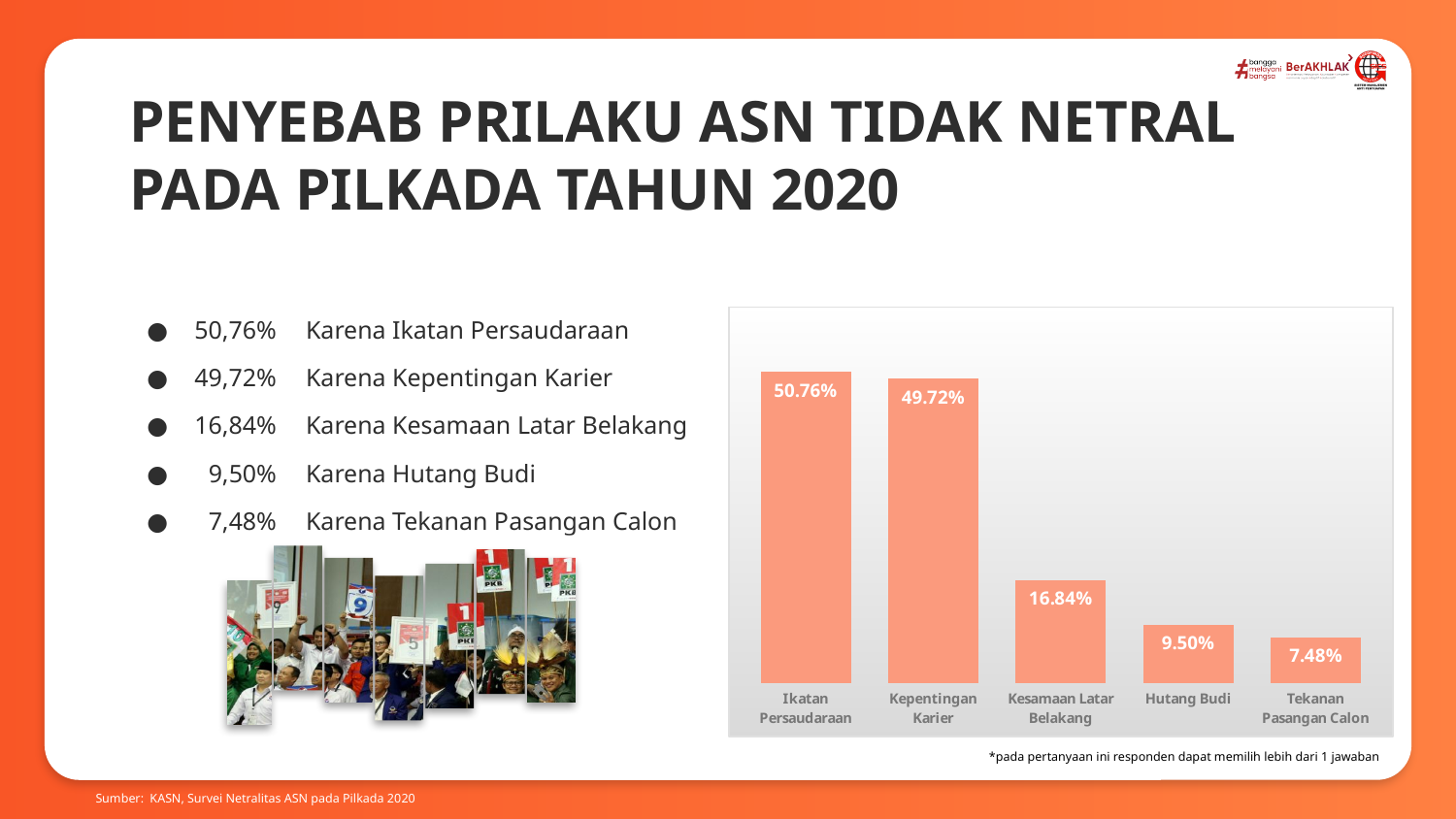
How many categories does the bar chart show? 5 What is the value for Ikatan Persaudaraan? 50.76% Which category has the lowest value? Tekanan Pasangan Calon What is the value for Hutang Budi? 9.50% Do the values rise or fall from left to right across the categories? fall What is the value for Kepentingan Karier? 49.72% What kind of chart is shown on the slide? bar chart What is the value for Tekanan Pasangan Calon? 7.48% Which category has the highest value? Ikatan Persaudaraan Which is larger, the value for Kesamaan Latar Belakang or the value for Hutang Budi? Kesamaan Latar Belakang What is the value for Kesamaan Latar Belakang? 16.84% What is the difference between the values for Ikatan Persaudaraan and Kepentingan Karier? 1.04%